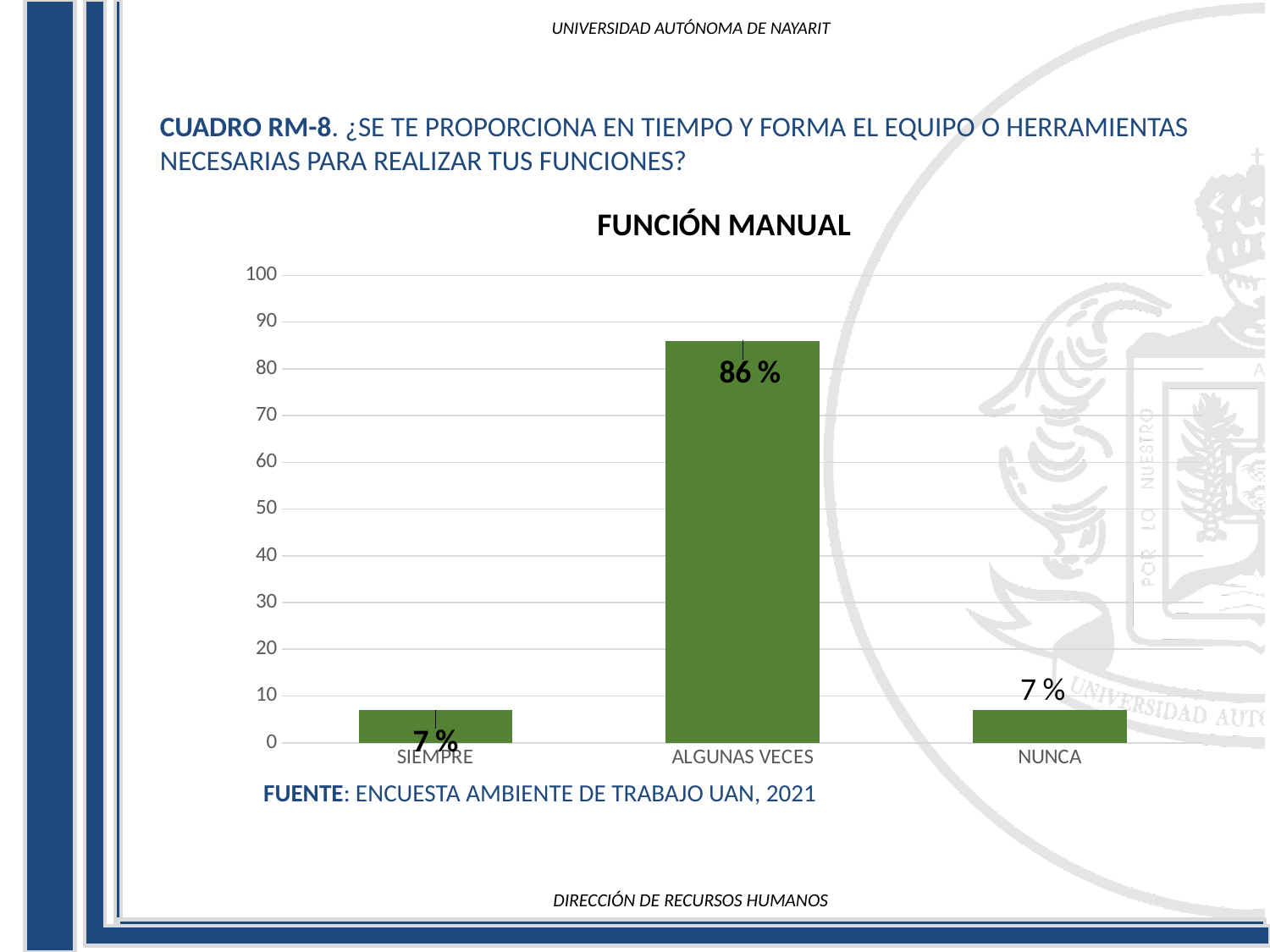
What kind of chart is shown on the slide? bar chart Is the value for NUNCA greater or less than 10? less Which category has the highest value? ALGUNAS VECES What is the value for NUNCA? 7 % What is the value for SIEMPRE? 7 % What is the title of the chart? FUNCIÓN MANUAL How many categories are shown on the x axis? 3 What is the value for ALGUNAS VECES? 86 % Which is larger, the value for ALGUNAS VECES or the value for SIEMPRE? ALGUNAS VECES What is the total of the three values shown in the chart? 100 % What is the difference between the values for ALGUNAS VECES and NUNCA? 79 % Is the value for ALGUNAS VECES greater or less than 80? greater